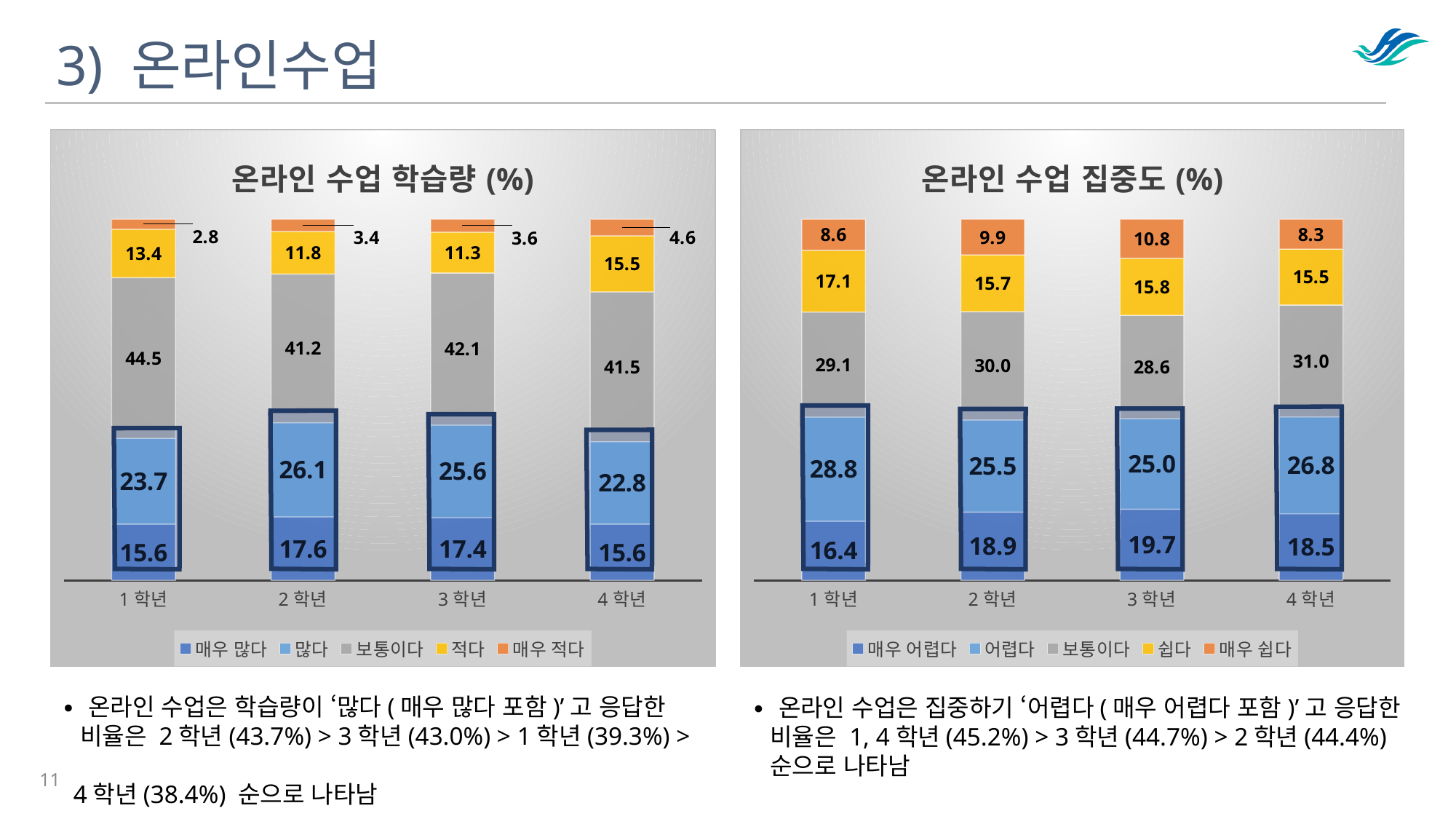
In the 온라인 수업 학습량 (%) chart, which grade has the highest value for 많다? 2 학년 In the 온라인 수업 학습량 (%) chart, what is the difference between the 매우 많다 values for 2 학년 and 1 학년? 2.0 In the 온라인 수업 학습량 (%) chart, what is the value of 보통이다 for 1 학년? 44.5 In the 온라인 수업 집중도 (%) chart, which grade has the highest value for 매우 쉽다? 3 학년 How many grade categories are shown on the x axis of the 온라인 수업 학습량 (%) chart? 4 What type of chart is the 온라인 수업 학습량 (%) chart? Stacked bar chart In the 온라인 수업 집중도 (%) chart, what is the difference between the 쉽다 values for 1 학년 and 4 학년? 1.6 In the 온라인 수업 집중도 (%) chart, which is larger, the 보통이다 value for 4 학년 or for 3 학년? 4 학년 How many series does the legend of the 온라인 수업 집중도 (%) chart list? 5 In the 온라인 수업 학습량 (%) chart, what is the value of 매우 적다 for 4 학년? 4.6 In the 온라인 수업 집중도 (%) chart, what is the value of 어렵다 for 1 학년? 28.8 In the 온라인 수업 학습량 (%) chart, which grade has the lowest value for 적다? 3 학년